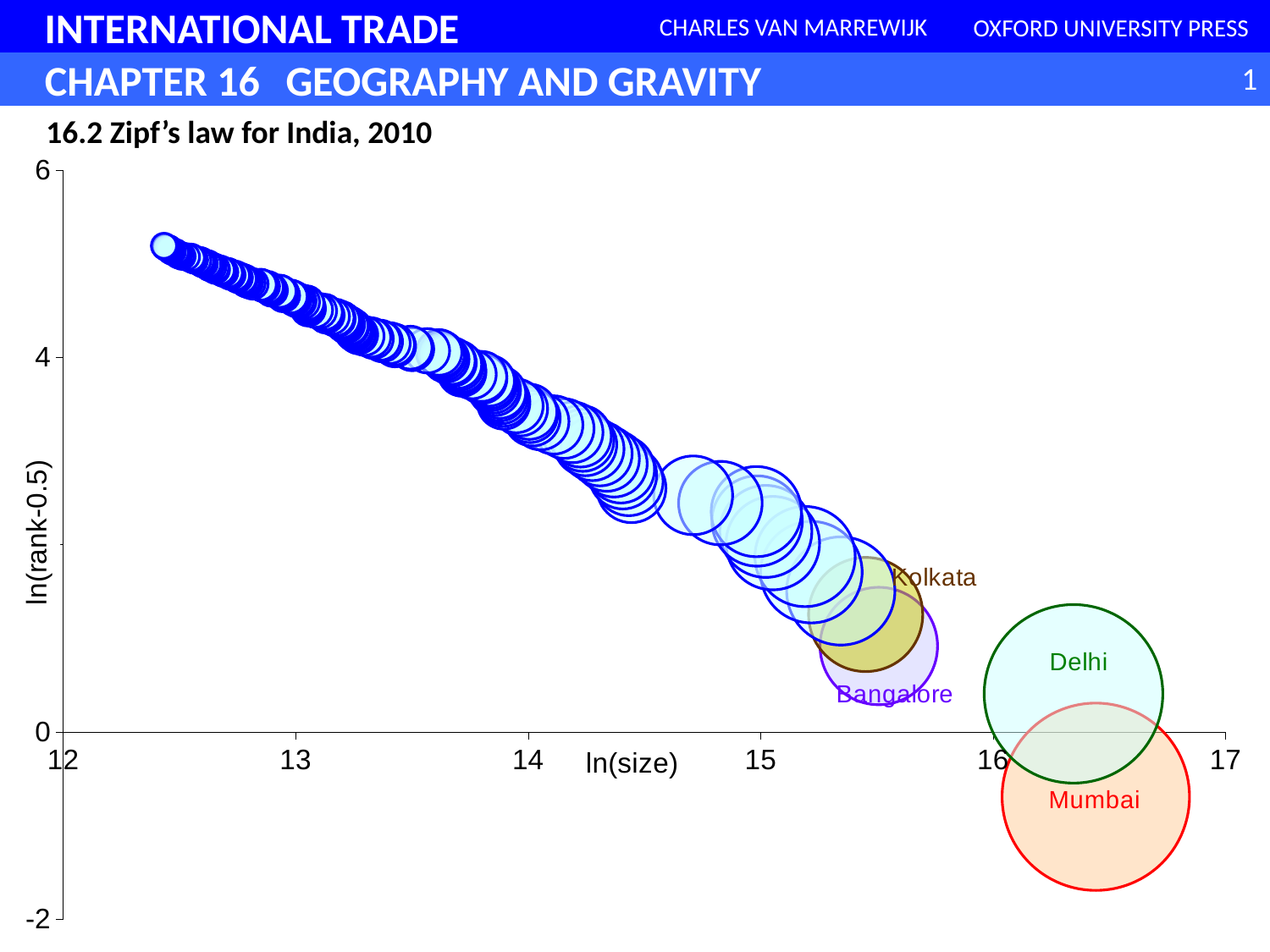
Is the ln(size) value for Mumbai greater or less than 16? greater Is the ln(size) value for Kolkata greater or less than 16? less Which labelled city has the largest ln(size)? Mumbai What is the title of the chart? 16.2 Zipf's law for India, 2010 What kind of chart is shown on the slide? Bubble (scatter) chart Is the ln(rank-0.5) value for Mumbai greater or less than 0? less Which has a larger ln(size), Delhi or Bangalore? Delhi What is the label of the x axis? ln(size) Which labelled city has the highest ln(rank-0.5)? Kolkata As ln(size) increases along the x axis, do the values of ln(rank-0.5) rise or fall? Fall How many cities are labelled by name on the chart? 4